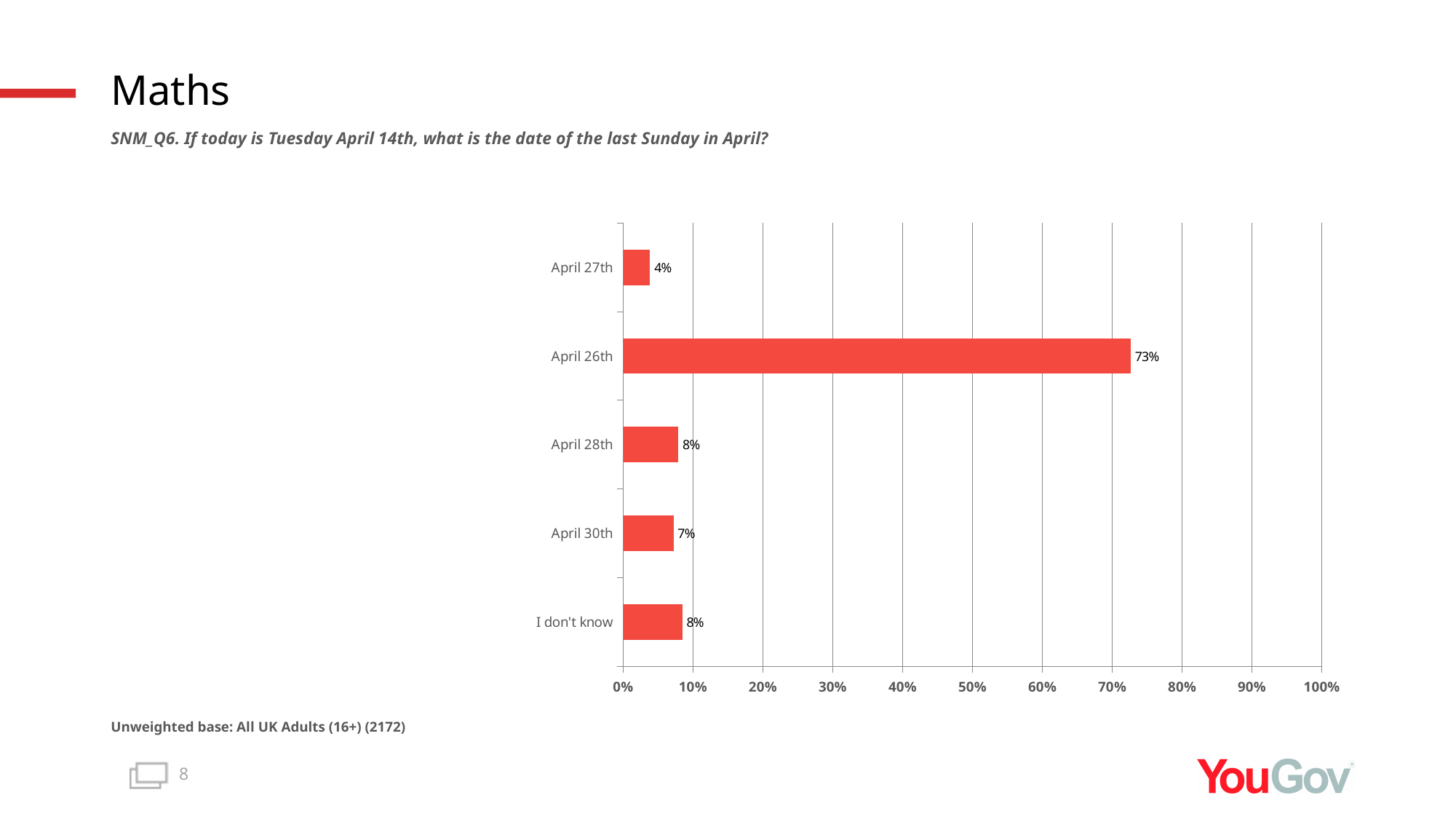
What is the unweighted base stated below the chart? All UK Adults (16+) (2172) What type of chart is shown on the slide? bar chart What percentage of respondents answered April 27th? 4% Which answer option has the highest percentage? April 26th How many answer options are shown in the chart? 5 What percentage of respondents answered April 26th? 73% Is the value for April 26th greater or less than 70%? greater Which has a larger percentage, April 30th or April 27th? April 30th What percentage of respondents answered 'I don't know'? 8% What percentage of respondents answered April 30th? 7% What is the difference in percentage points between April 26th and April 28th? 65 Which answer option has the lowest percentage? April 27th